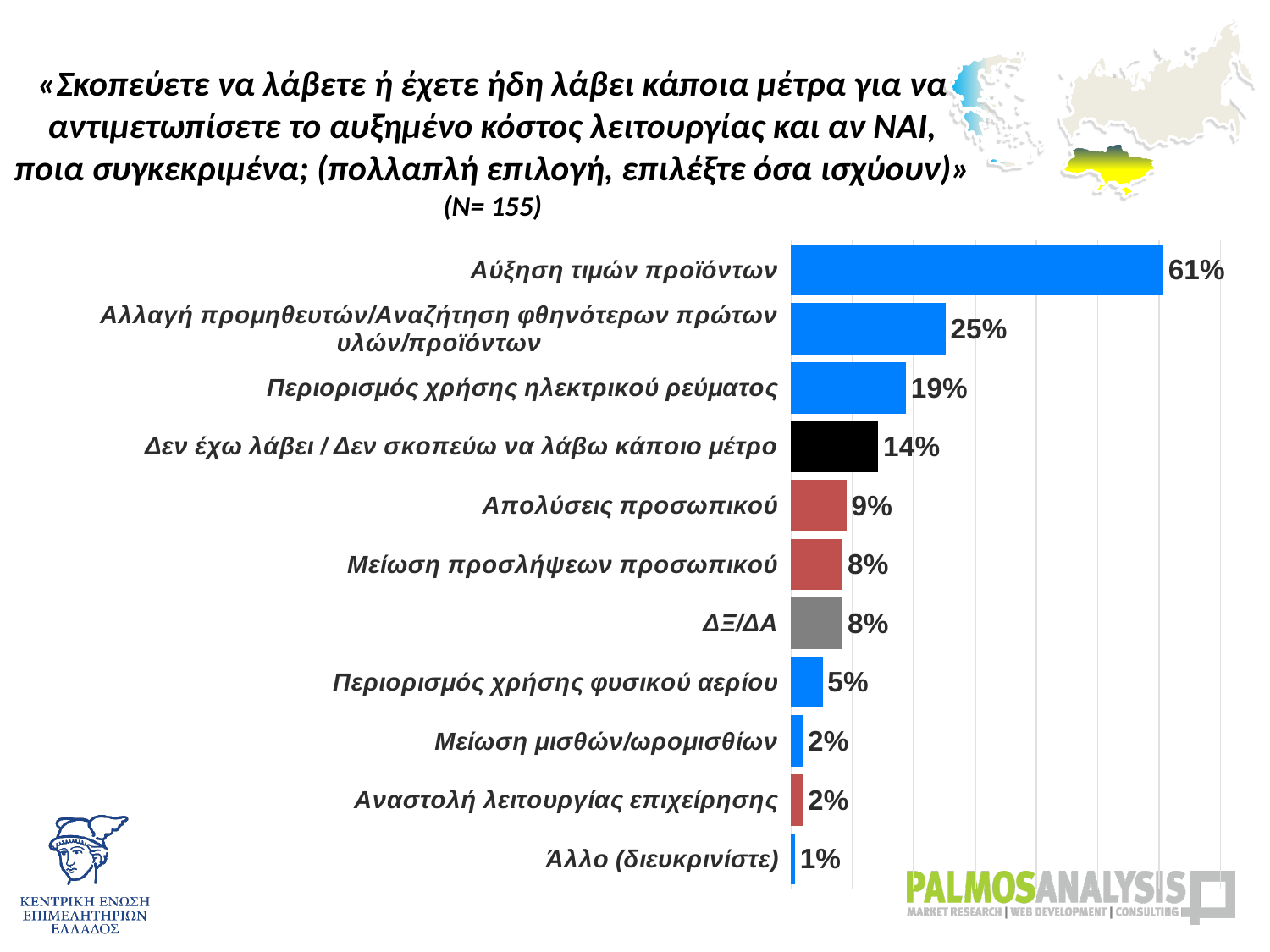
What is the value for Δεν έχω λάβει / Δεν σκοπεύω να λάβω κάποιο μέτρο? 14% What is the difference between Απολύσεις προσωπικού and Μείωση προσλήψεων προσωπικού? 1% Which category has the highest value? Αύξηση τιμών προϊόντων What is the value for Περιορισμός χρήσης ηλεκτρικού ρεύματος? 19% Which is larger, Περιορισμός χρήσης ηλεκτρικού ρεύματος or Δεν έχω λάβει / Δεν σκοπεύω να λάβω κάποιο μέτρο? Περιορισμός χρήσης ηλεκτρικού ρεύματος What is the value for Περιορισμός χρήσης φυσικού αερίου? 5% What is the value for Αύξηση τιμών προϊόντων? 61% What is the difference between Αύξηση τιμών προϊόντων and Αλλαγή προμηθευτών/Αναζήτηση φθηνότερων πρώτων υλών/προϊόντων? 36% What is the sample size (N) stated on the slide? 155 What kind of chart is shown on the slide? Bar chart Which category has the lowest value? Άλλο (διευκρινίστε) How many categories are shown in the chart? 11